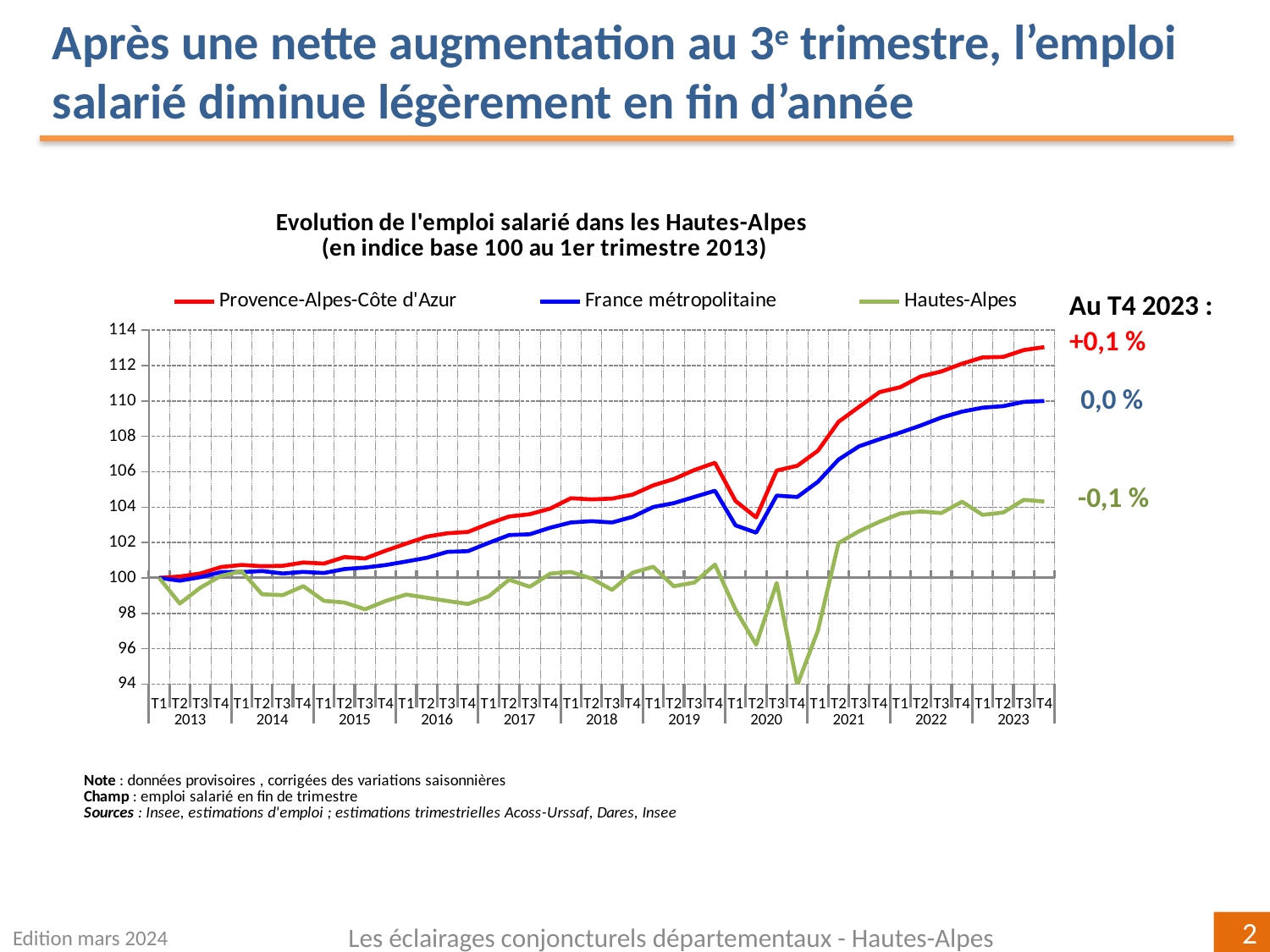
What kind of chart is shown on the slide? line chart What is the base value of the index at T1 2013, as shown on the chart? 100 According to the annotation on the right, what is the change for Provence-Alpes-Côte d'Azur at T4 2023? +0,1 % Which series is drawn in green in the chart? Hautes-Alpes How many series does the legend list? 3 At T4 2023, which is higher: Provence-Alpes-Côte d'Azur or Hautes-Alpes? Provence-Alpes-Côte d'Azur How many years are labelled along the x axis? 11 Does the Provence-Alpes-Côte d'Azur line rise or fall overall from 2013 to 2023? rise Is the value for Hautes-Alpes at T4 2020 greater or less than 96? less Is the value for Provence-Alpes-Côte d'Azur at T4 2023 greater or less than 112? greater Is the value for France métropolitaine at T4 2021 greater or less than 106? greater Which series has the lowest value at T4 2020? Hautes-Alpes